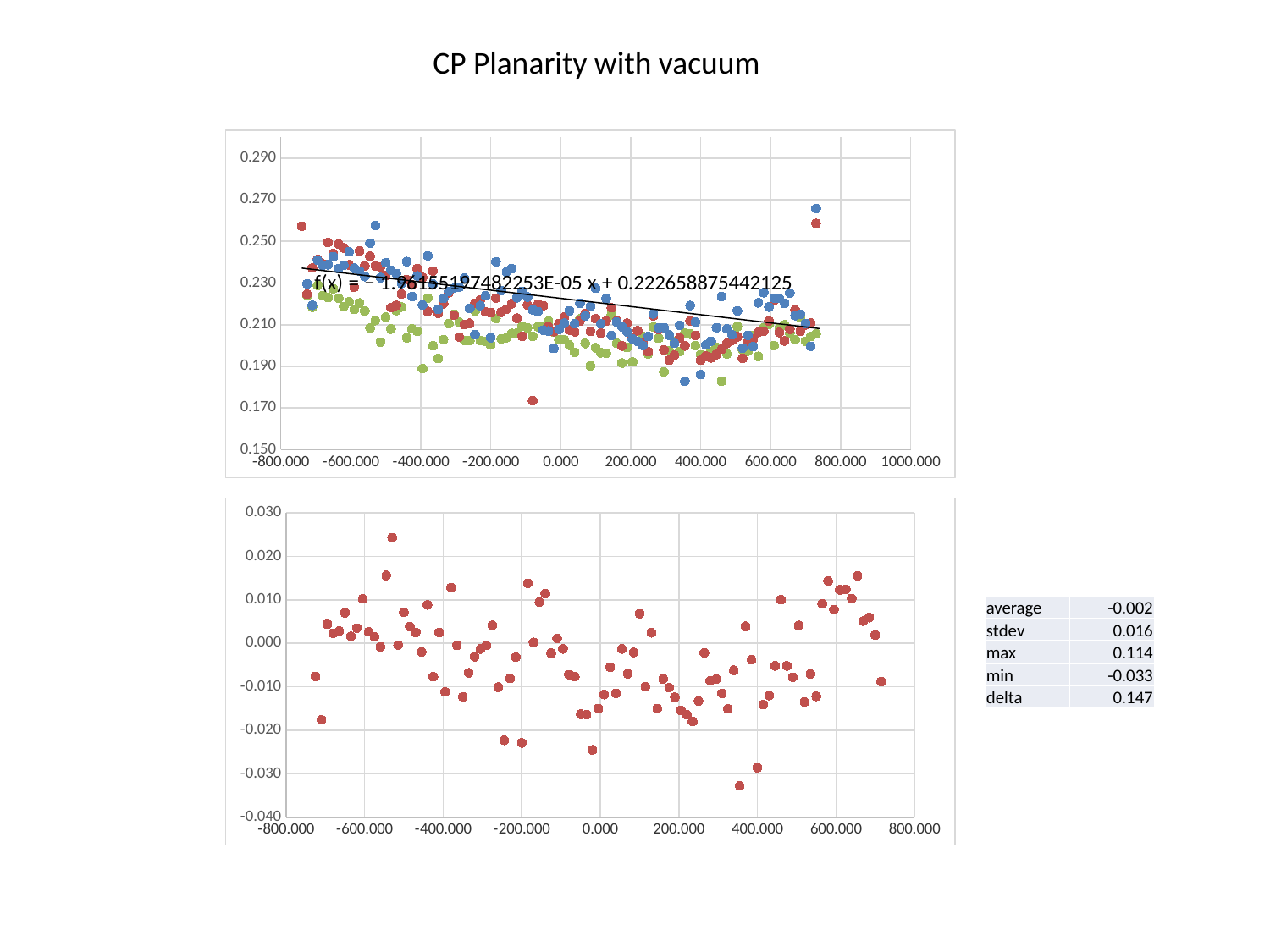
In the bottom chart, is the lowest plotted point (near x = 350) greater or less than -0.030? less In the bottom chart, is the highest plotted point (near x = -530) greater or less than 0.020? greater In the top chart, do the plotted values generally rise or fall as x increases from -800.000 to 800.000? fall What kind of chart is the top chart on the slide? scatter chart What is the intercept value shown in the trendline equation on the top chart? 0.222658875442125 In the bottom chart, is the point near x = 650 greater or less than 0.010? greater What kind of chart is the bottom chart on the slide? scatter chart What is the maximum value shown on the y axis of the top chart? 0.290